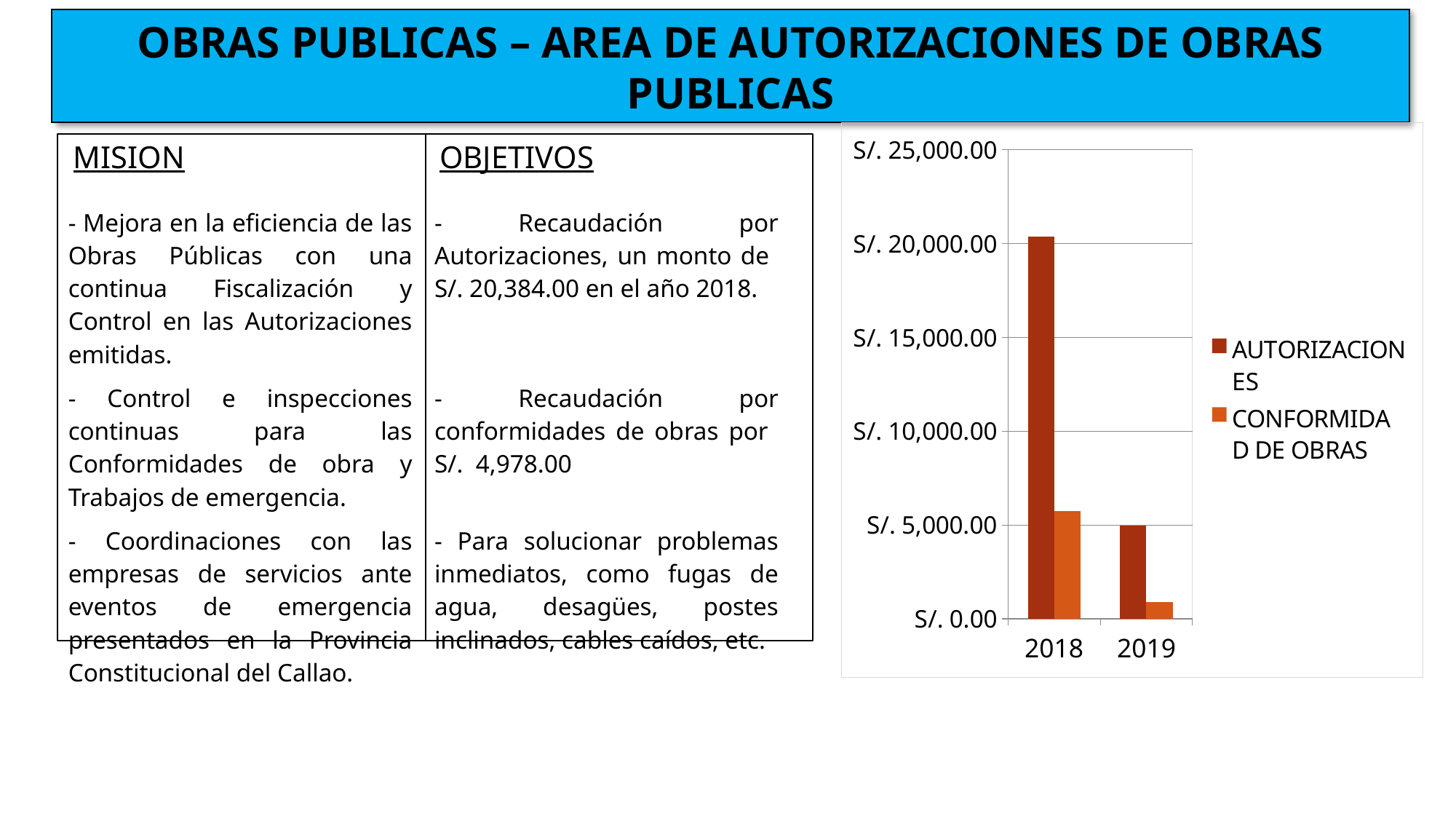
Is the value for AUTORIZACIONES in 2018 greater or less than S/. 15,000.00? greater How many years are shown on the x axis of the chart? 2 Do the CONFORMIDAD DE OBRAS values rise or fall from 2018 to 2019? Fall In which year is the CONFORMIDAD DE OBRAS bar lowest? 2019 What kind of chart is shown on the slide? Bar chart Do the AUTORIZACIONES values rise or fall from 2018 to 2019? Fall How many series does the chart legend list? 2 Is the value for CONFORMIDAD DE OBRAS in 2019 greater or less than S/. 5,000.00? less In 2018, which series has the larger value, AUTORIZACIONES or CONFORMIDAD DE OBRAS? AUTORIZACIONES What is the highest tick label shown on the chart's vertical axis? S/. 25,000.00 Is the value for CONFORMIDAD DE OBRAS in 2018 greater or less than S/. 10,000.00? less In which year is the AUTORIZACIONES bar highest? 2018